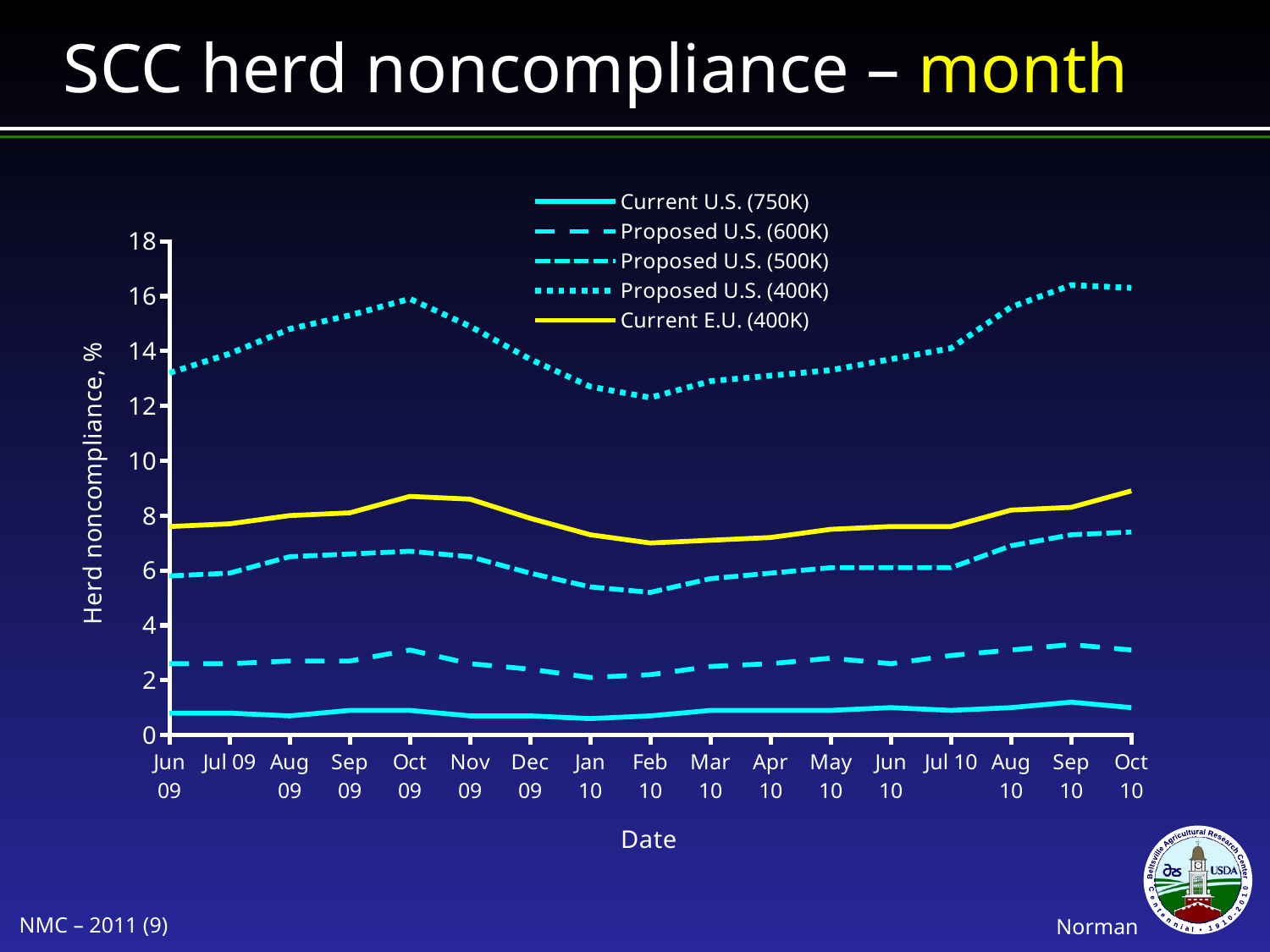
How many months are plotted along the x axis? 17 Which is larger in Feb 10, Current E.U. (400K) or Proposed U.S. (500K)? Current E.U. (400K) How many series does the legend list? 5 Which series has the lowest herd noncompliance across all months? Current U.S. (750K) In which month is the Current E.U. (400K) series at its lowest? Feb 10 What kind of chart is shown on the slide? line chart Is the value for Proposed U.S. (400K) in Jun 09 greater or less than 12? greater What is the label of the y axis? Herd noncompliance, % Does the Proposed U.S. (400K) series rise or fall from Feb 10 to Oct 10? rise Which series has the highest herd noncompliance across all months? Proposed U.S. (400K) Is the value for Current U.S. (750K) in Oct 10 greater or less than 2? less In which month is the Proposed U.S. (400K) series at its lowest? Feb 10